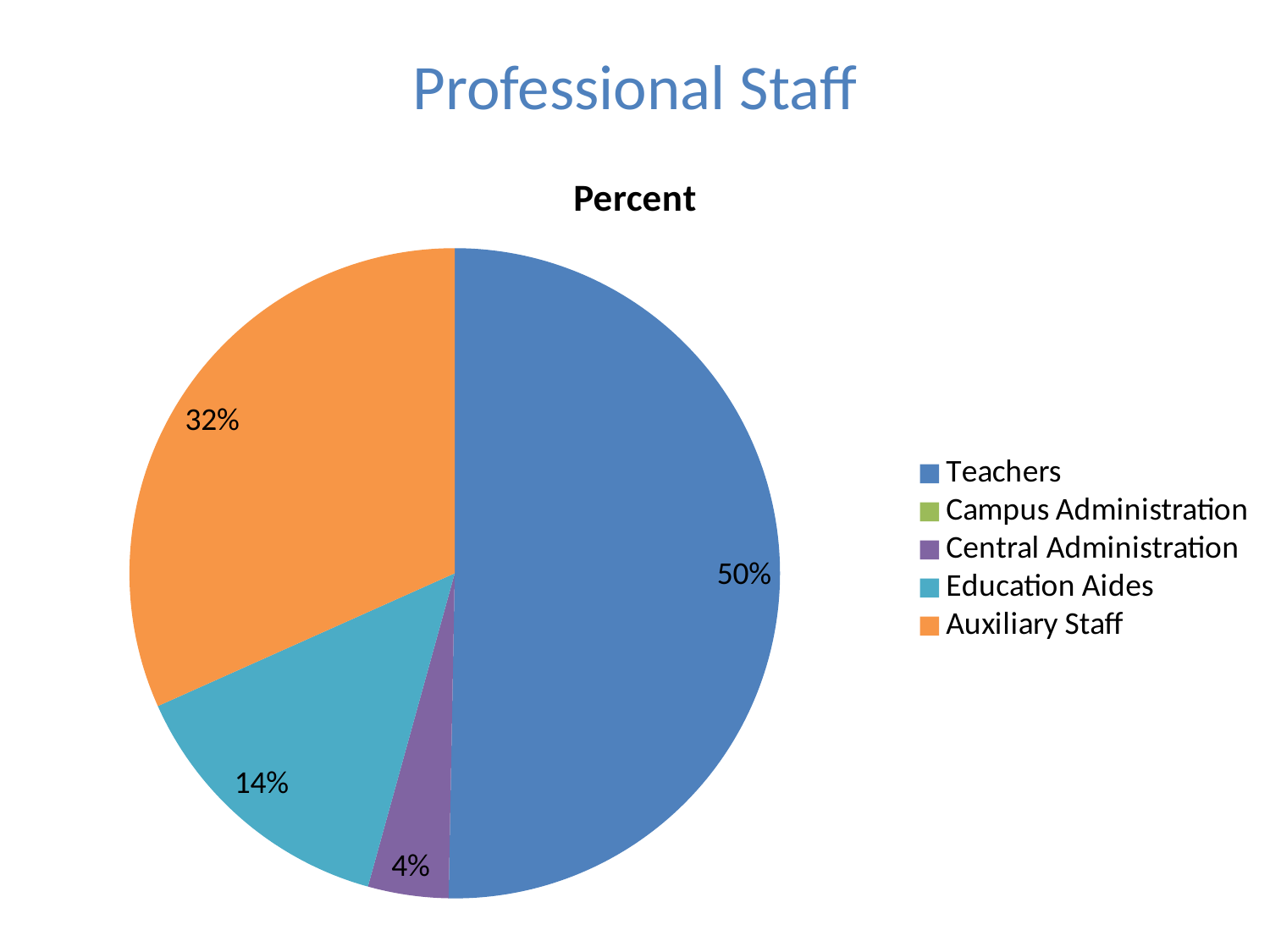
Which of the labelled slices is the smallest? Central Administration What percentage of professional staff are Auxiliary Staff? 32% What colour is the Auxiliary Staff slice? orange What percentage of professional staff are Teachers? 50% Which is larger, the share for Education Aides or the share for Central Administration? Education Aides What percentage of professional staff are Central Administration? 4% What percentage of professional staff are Education Aides? 14% What is the difference in percentage points between Teachers and Auxiliary Staff? 18 What type of chart is shown on the slide? pie chart How many entries does the legend list? 5 What is the chart's title? Percent Which category has the largest share of the pie? Teachers